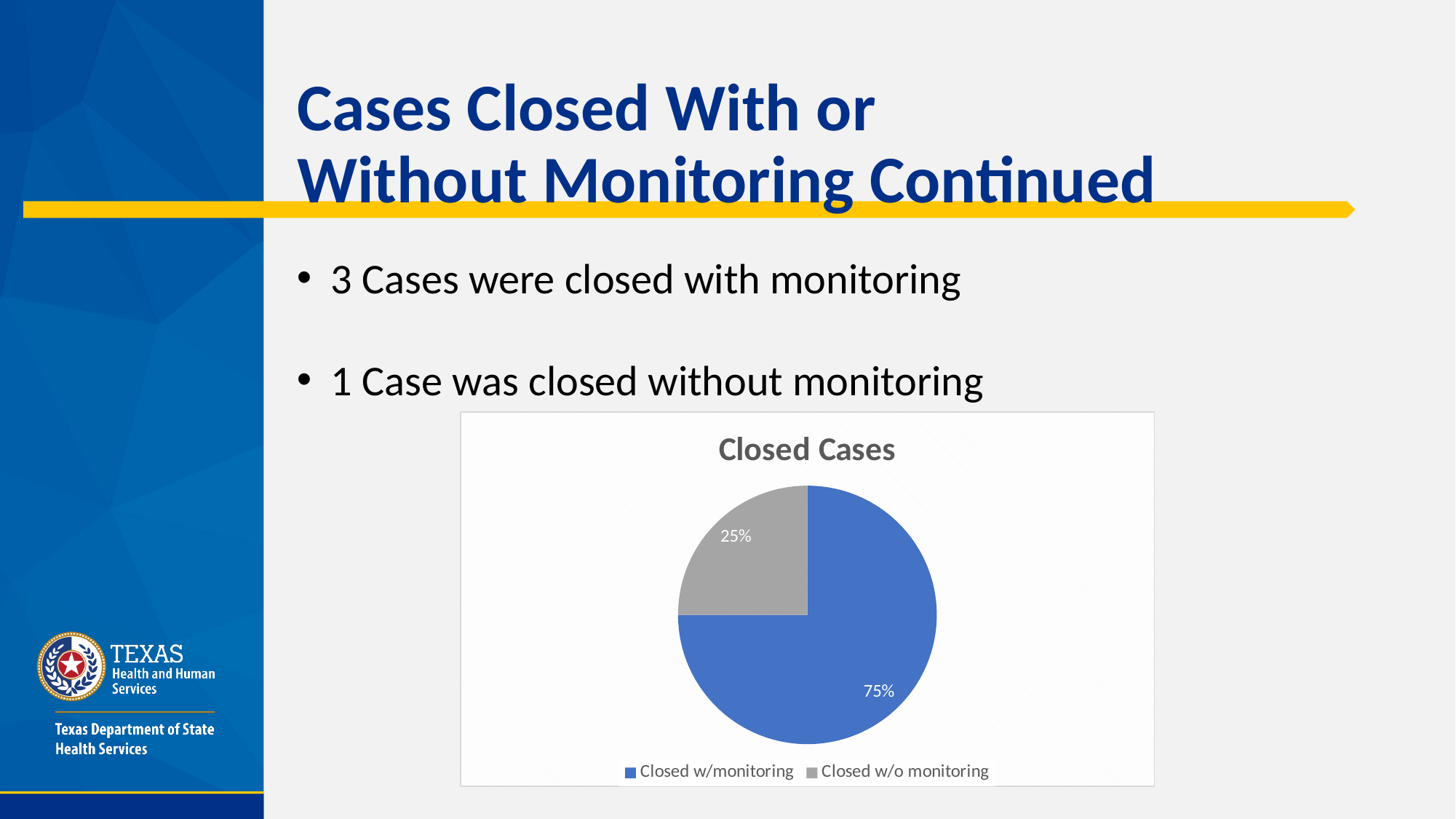
What is the title of the chart? Closed Cases How many entries does the legend list? 2 What percentage of the pie is labelled for Closed w/monitoring? 75% Which slice is larger, Closed w/monitoring or Closed w/o monitoring? Closed w/monitoring What type of chart is shown on the slide? pie chart Which category has the smallest share of the pie? Closed w/o monitoring What is the difference in percentage points between the Closed w/monitoring slice and the Closed w/o monitoring slice? 50 What percentage of the pie is labelled for Closed w/o monitoring? 25% How many slices does the pie chart have? 2 What share of the pie does the Closed w/monitoring slice represent? 75% What colour is the Closed w/o monitoring slice? gray Which category has the largest share of the pie? Closed w/monitoring